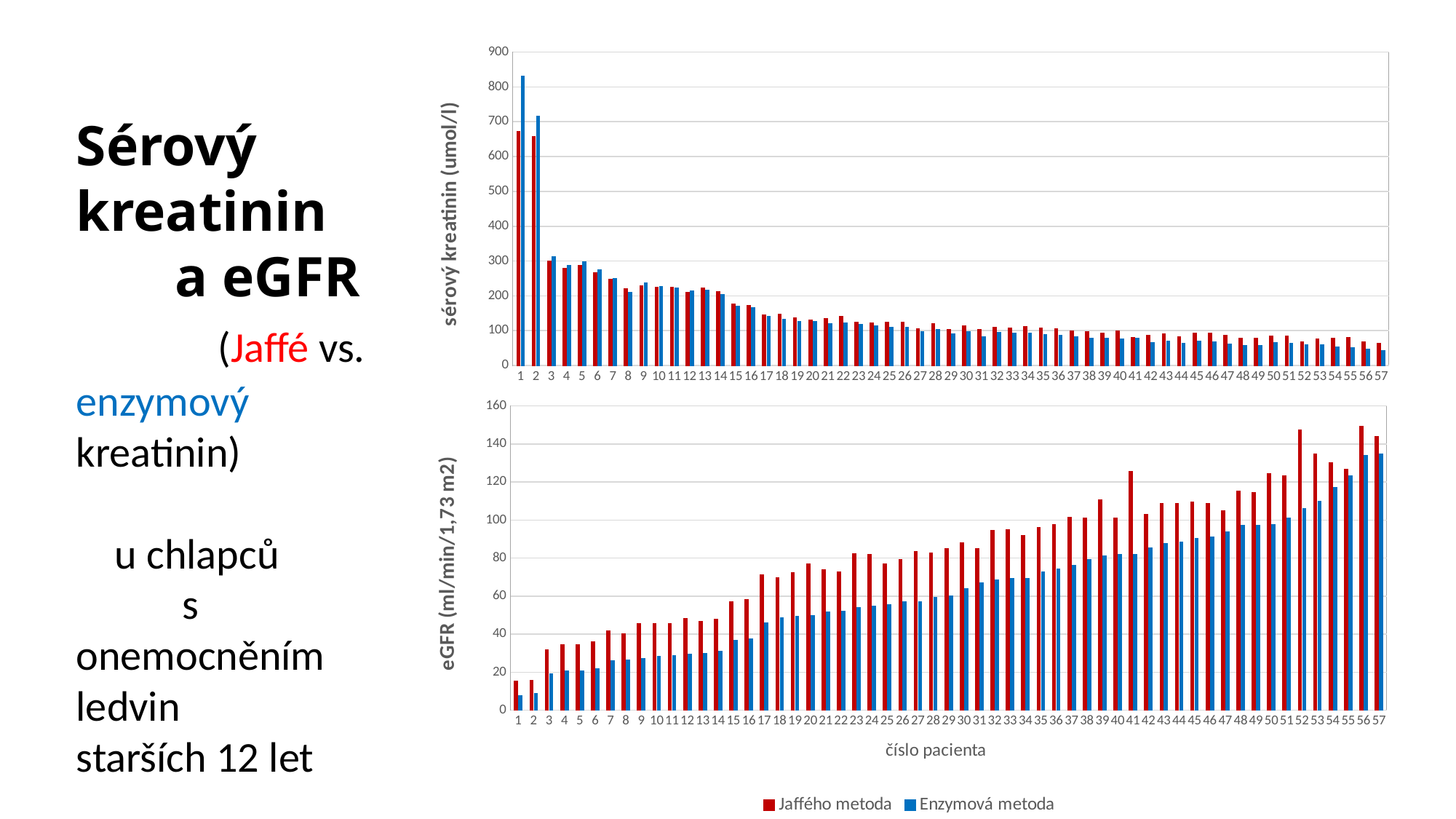
What kind of chart is the top chart (sérový kreatinin)? bar chart In the top chart (sérový kreatinin), do the values generally rise or fall from patient 1 to patient 57? fall In the top chart (sérový kreatinin), is the Enzymová metoda value for patient 1 greater or less than 800? greater In the bottom chart (eGFR), do the values generally rise or fall from patient 1 to patient 57? rise In the top chart (sérový kreatinin), which patient has the highest value? 1 In the top chart (sérový kreatinin), is the Enzymová metoda value for patient 57 greater or less than 100? less How many series does the legend list for the charts? 2 How many patients (categories) are shown on the x axis of the bottom chart (eGFR)? 57 Which colour represents Jaffého metoda in the charts? red In the bottom chart (eGFR), for patient 41, which is larger: Jaffého metoda or Enzymová metoda? Jaffého metoda In the top chart (sérový kreatinin), for patient 1, which is larger: Jaffého metoda or Enzymová metoda? Enzymová metoda In the bottom chart (eGFR), is the Jaffého metoda value for patient 52 greater or less than 140? greater